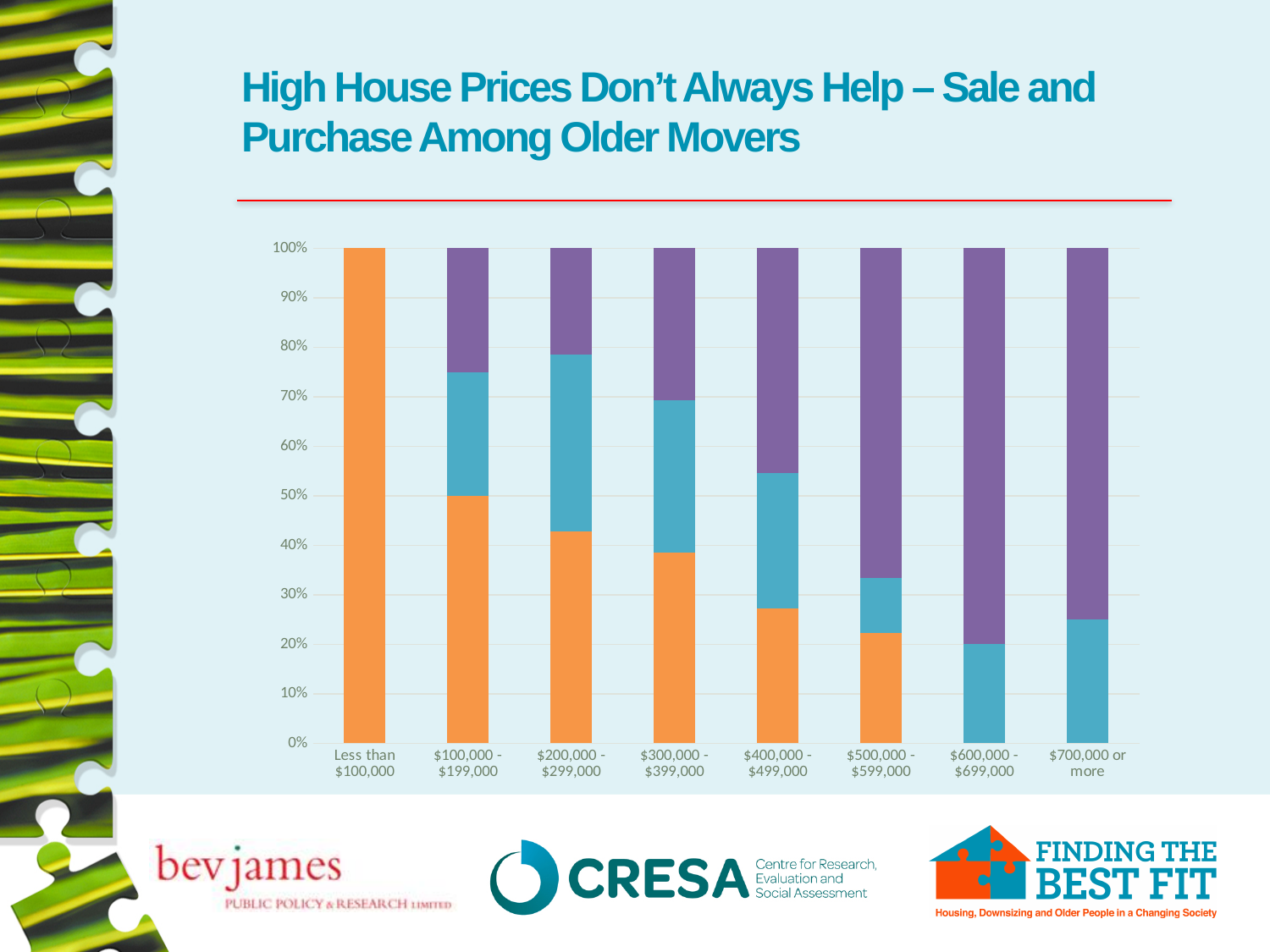
What kind of chart is shown on the slide? Stacked bar chart Is the top of the teal segment for '$700,000 or more' greater or less than 30%? less Is the orange segment for '$200,000 - $299,000' greater or less than 40%? greater Does the top of the teal segment for '$300,000 - $399,000' sit above or below 60%? above Moving from left to right across the price categories, does the orange segment rise or fall? fall How many differently coloured segments are used in the stacked bars? 3 Which categories have no orange segment at all? $600,000 - $699,000 and $700,000 or more What percentage does the orange segment reach for the 'Less than $100,000' category? 100% Which category's bar is made up entirely of the orange segment, reaching 100%? Less than $100,000 How many house price categories are shown along the x axis? 8 Which has the larger orange segment: '$100,000 - $199,000' or '$500,000 - $599,000'? $100,000 - $199,000